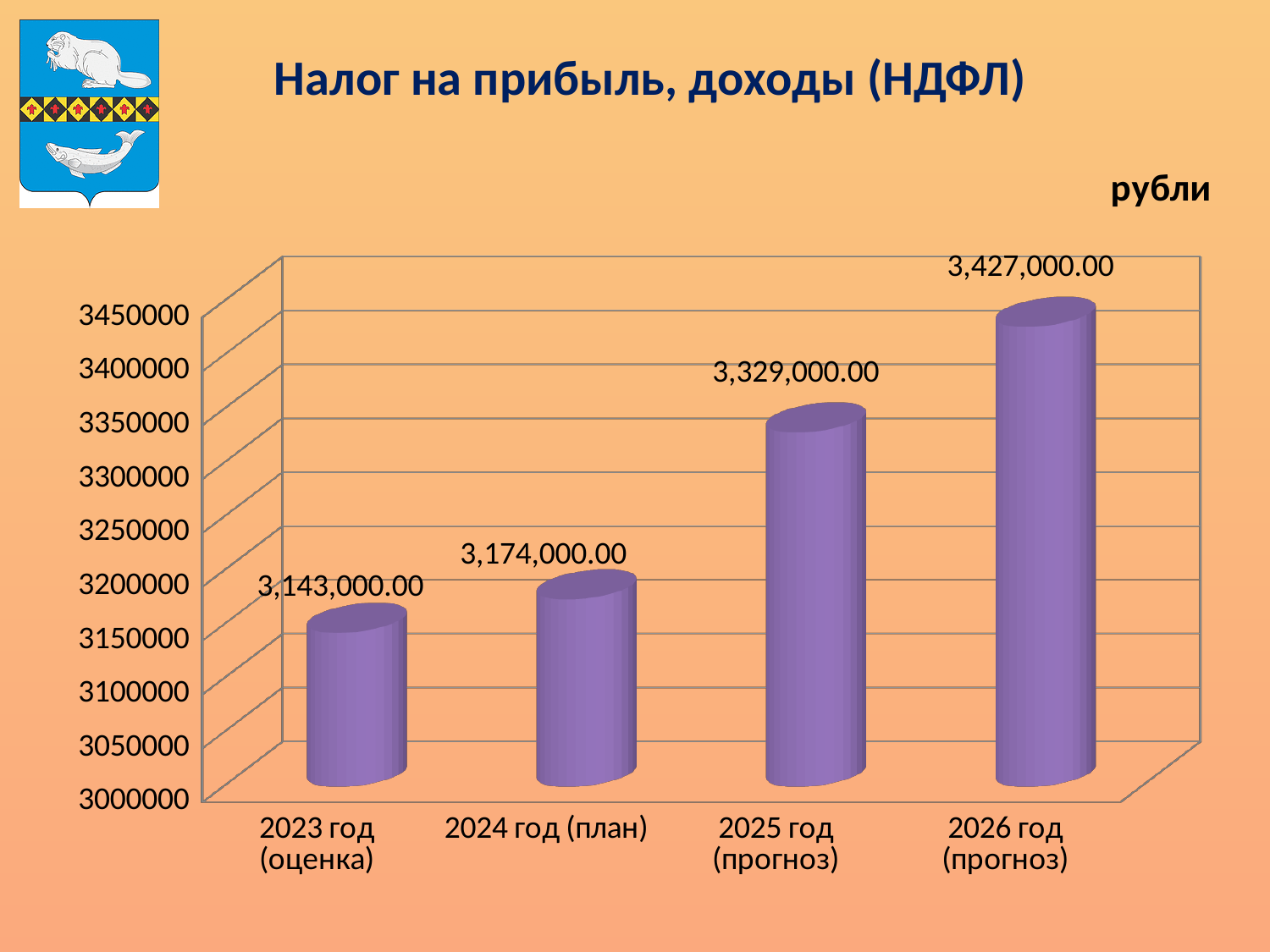
Which is larger, the value for 2024 год (план) or the value for 2025 год (прогноз)? 2025 год (прогноз) What is the difference between the values for 2026 год (прогноз) and 2023 год (оценка)? 284,000.00 What is the value for 2024 год (план)? 3,174,000.00 Do the values rise or fall from 2023 to 2026? rise What is the difference between the values for 2025 год (прогноз) and 2024 год (план)? 155,000.00 Which category has the lowest value? 2023 год (оценка) What is the value for 2026 год (прогноз)? 3,427,000.00 What is the value for 2023 год (оценка)? 3,143,000.00 Which category has the highest value? 2026 год (прогноз) What is the value for 2025 год (прогноз)? 3,329,000.00 How many categories are shown in the chart? 4 What kind of chart is shown on the slide? bar chart